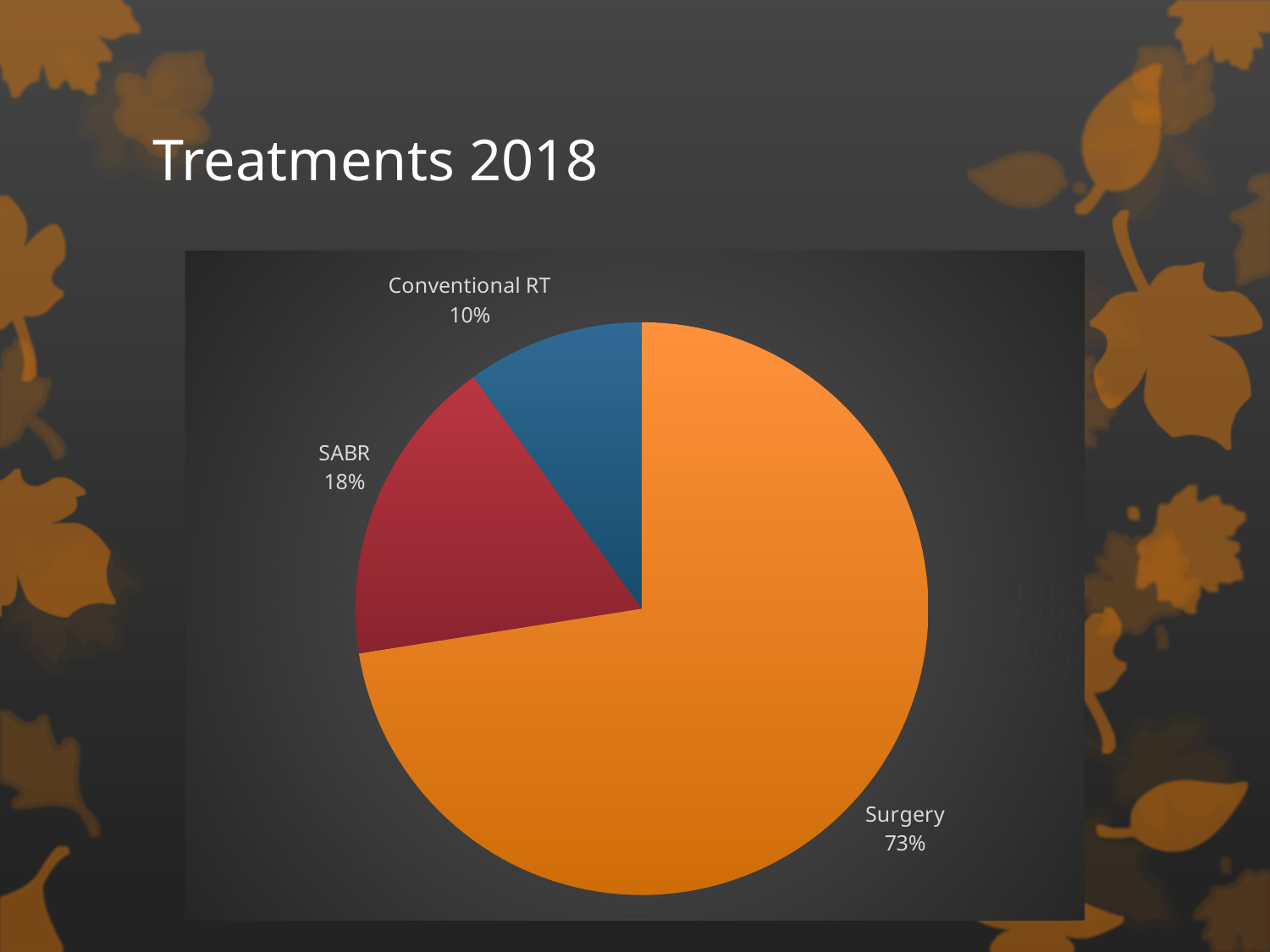
What kind of chart is shown on the slide? pie chart What share of the pie does Surgery represent? 73% Which is larger, the share for SABR or the share for Conventional RT? SABR What colour is the Surgery slice of the pie? orange What is the difference in percentage points between Surgery and SABR? 55 What share of the pie does Conventional RT represent? 10% How many slices does the pie chart have? 3 What share of the pie does SABR represent? 18% Which treatment has the smallest slice of the pie? Conventional RT Which treatment has the largest slice of the pie? Surgery What is the title of the slide containing the pie chart? Treatments 2018 What is the difference in percentage points between SABR and Conventional RT? 8